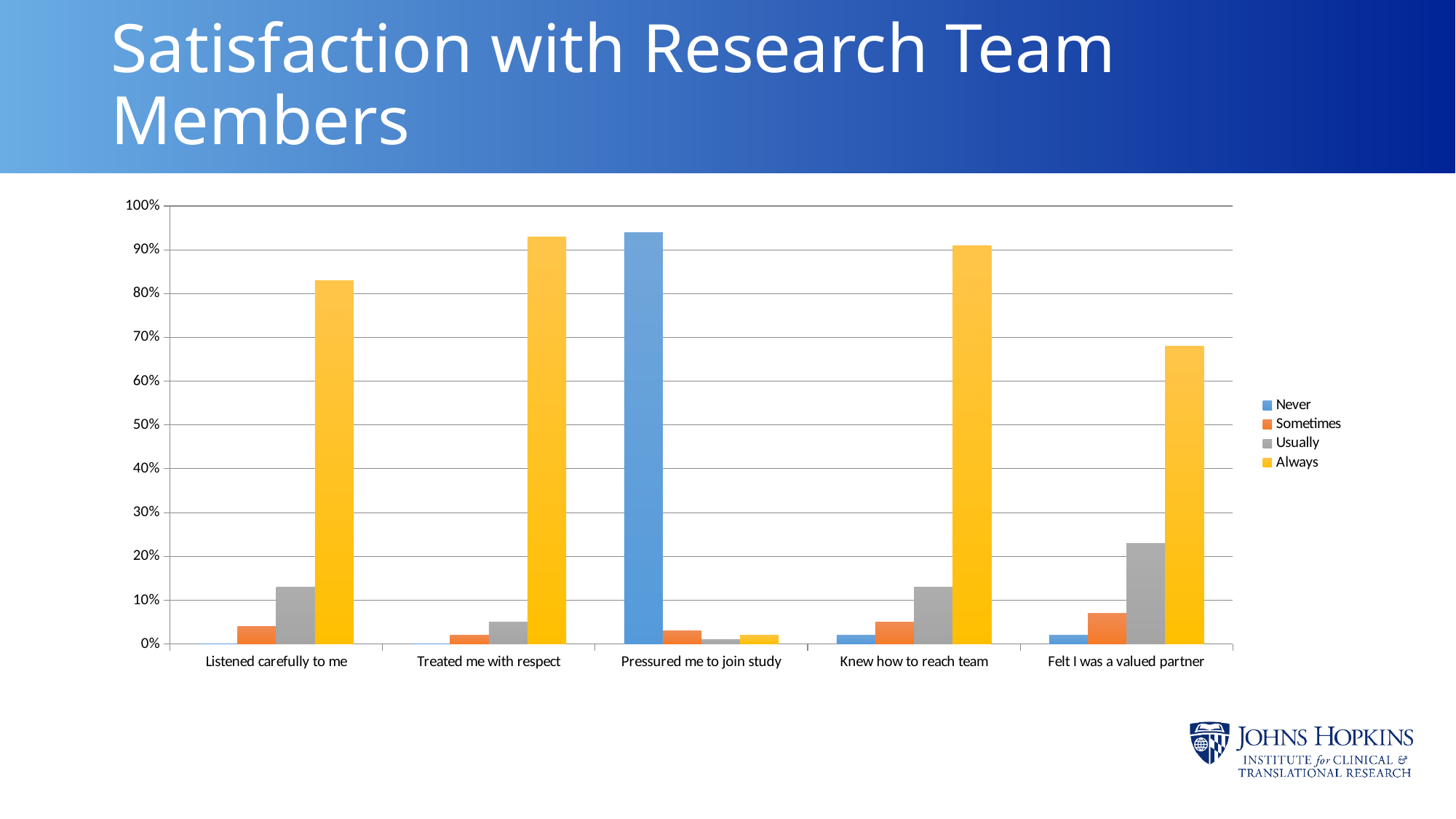
Is the "Always" value for "Felt I was a valued partner" greater or less than 70%? less How many series does the chart's legend list? 4 Which series has the tallest bar for "Listened carefully to me"? Always How many categories are shown along the x axis of the chart? 5 What kind of chart is shown on the slide? Bar chart Is the "Always" value for "Treated me with respect" greater or less than 90%? greater Which category has the larger "Usually" value: "Felt I was a valued partner" or "Listened carefully to me"? Felt I was a valued partner Which category has the lowest "Always" value? Pressured me to join study Which colour represents the "Always" series in the chart? Yellow Is the "Always" value for "Listened carefully to me" greater or less than 80%? greater Which series has the tallest bar for "Pressured me to join study"? Never